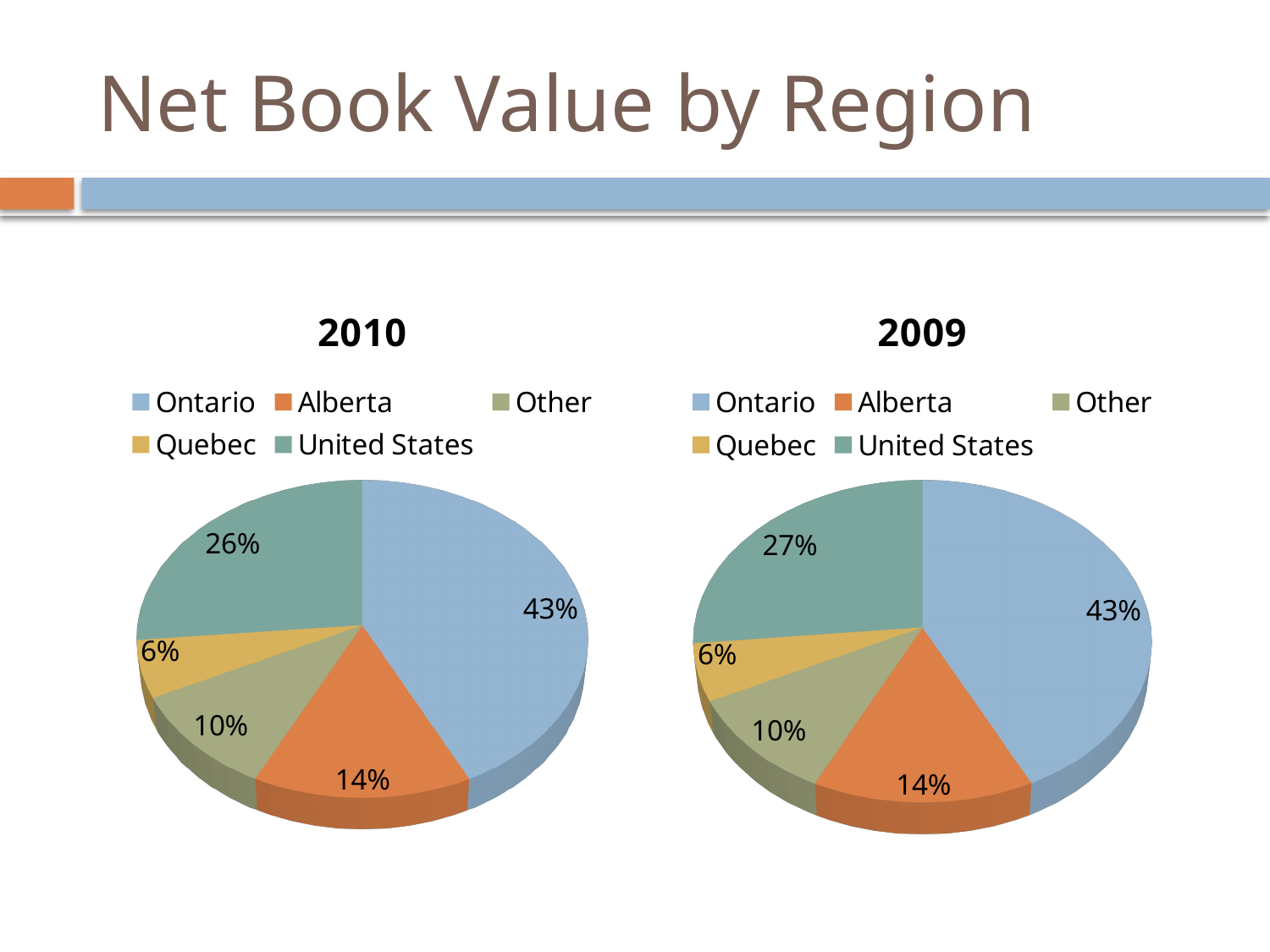
In the 2010 chart, which region has the largest share? Ontario What kind of chart is the 2009 chart? Pie chart In the 2009 chart, what is the value for Alberta? 14% In the 2010 chart, what share of net book value does Ontario have? 43% In the 2010 chart, what is the value for Quebec? 6% In the 2009 chart, which is larger, the share for Other or the share for Alberta? Alberta In the 2009 chart, which region has the smallest share? Quebec How many regions are shown in the 2010 chart? 5 In the 2010 chart, which colour represents Alberta? Orange What is the title of the slide? Net Book Value by Region In the 2009 chart, what share of net book value does the United States have? 27% In the 2010 chart, what is the difference between the Ontario and United States shares? 17%